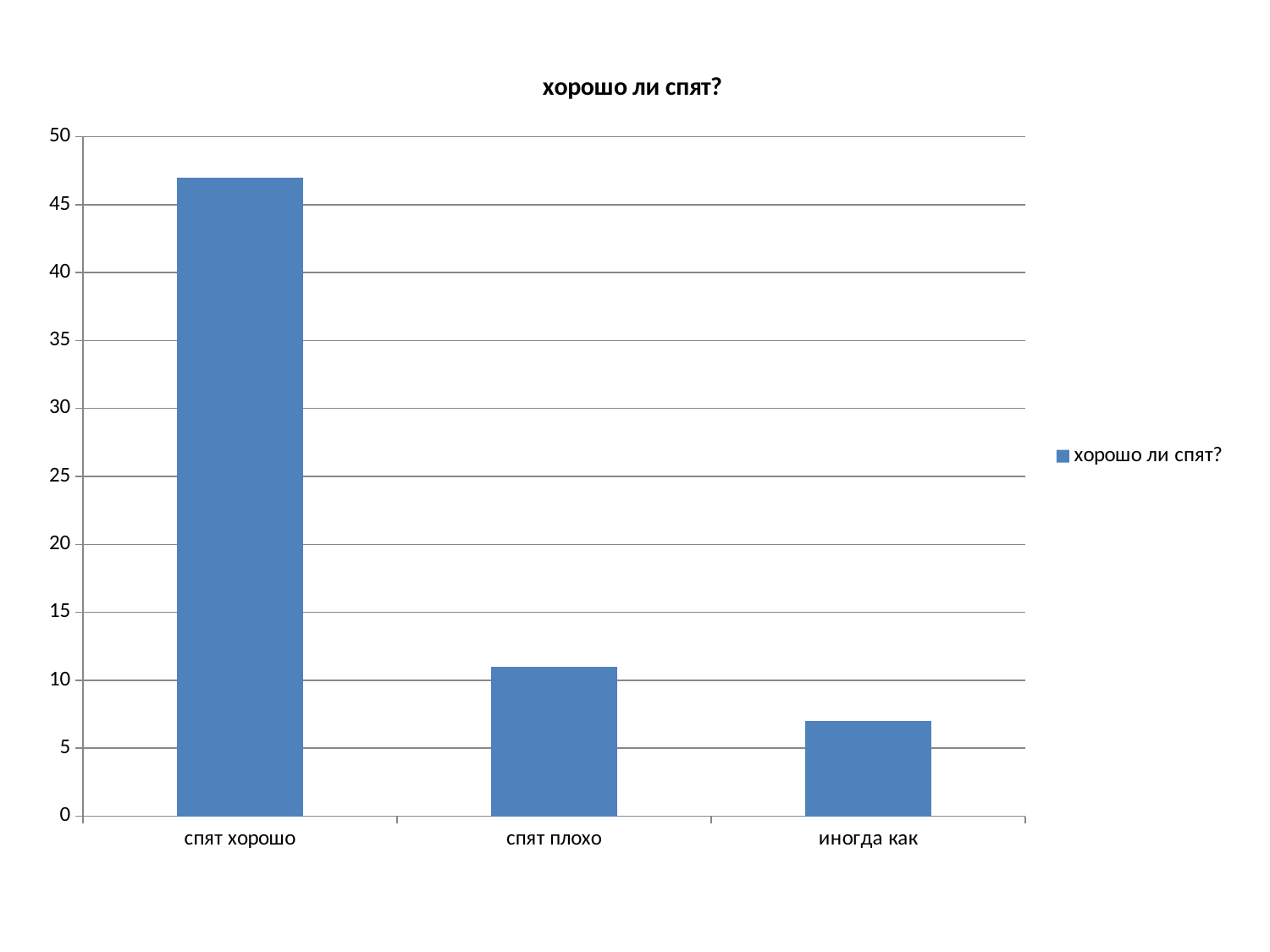
Which category has the lowest value? иногда как Which is larger, the value for спят плохо or the value for иногда как? спят плохо Which category has the highest value? спят хорошо Is the value for спят плохо greater or less than 10? greater Is the value for иногда как greater or less than 10? less What is the title of the chart? хорошо ли спят? What kind of chart is shown on the slide? bar chart Do the values rise or fall from left to right along the x axis? fall What is the name of the series shown in the legend? хорошо ли спят? How many series does the legend list? 1 How many categories are shown on the x axis of the chart? 3 Is the value for спят хорошо greater or less than 45? greater